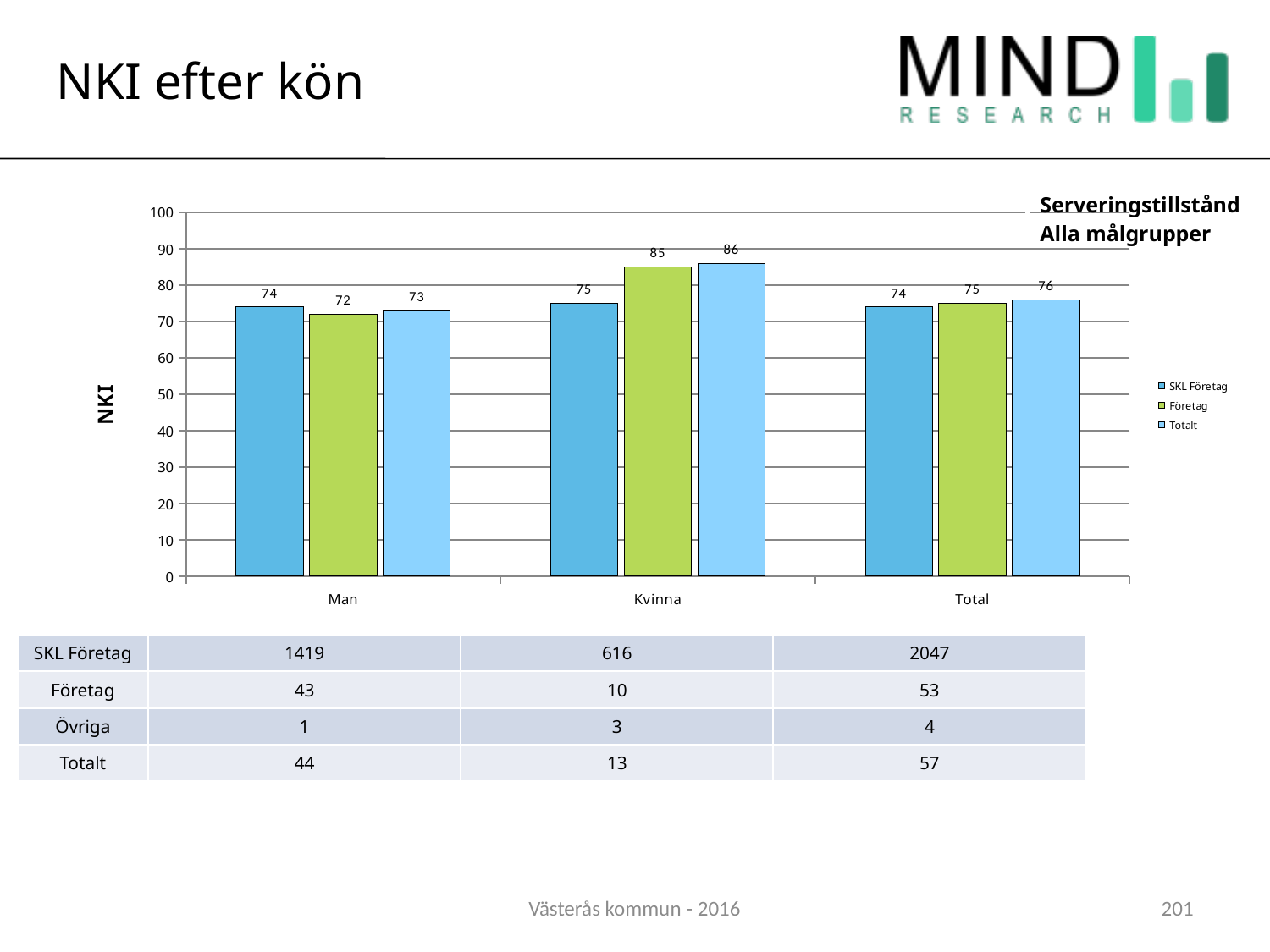
Which category has the highest Totalt value? Kvinna What is the value for Totalt in the Total category? 76 What is the value for Företag in the Kvinna category? 85 Which category has the lowest Företag value? Man What kind of chart is shown? bar chart Is the value for Totalt in the Kvinna category greater or less than 80? greater What is the difference between the Totalt values for Kvinna and Man? 13 Which is larger: the Företag value for Kvinna or the Företag value for Total? Kvinna What is the label on the y axis? NKI How many categories are shown on the x axis? 3 What is the value for SKL Företag in the Man category? 74 How many series does the legend list? 3